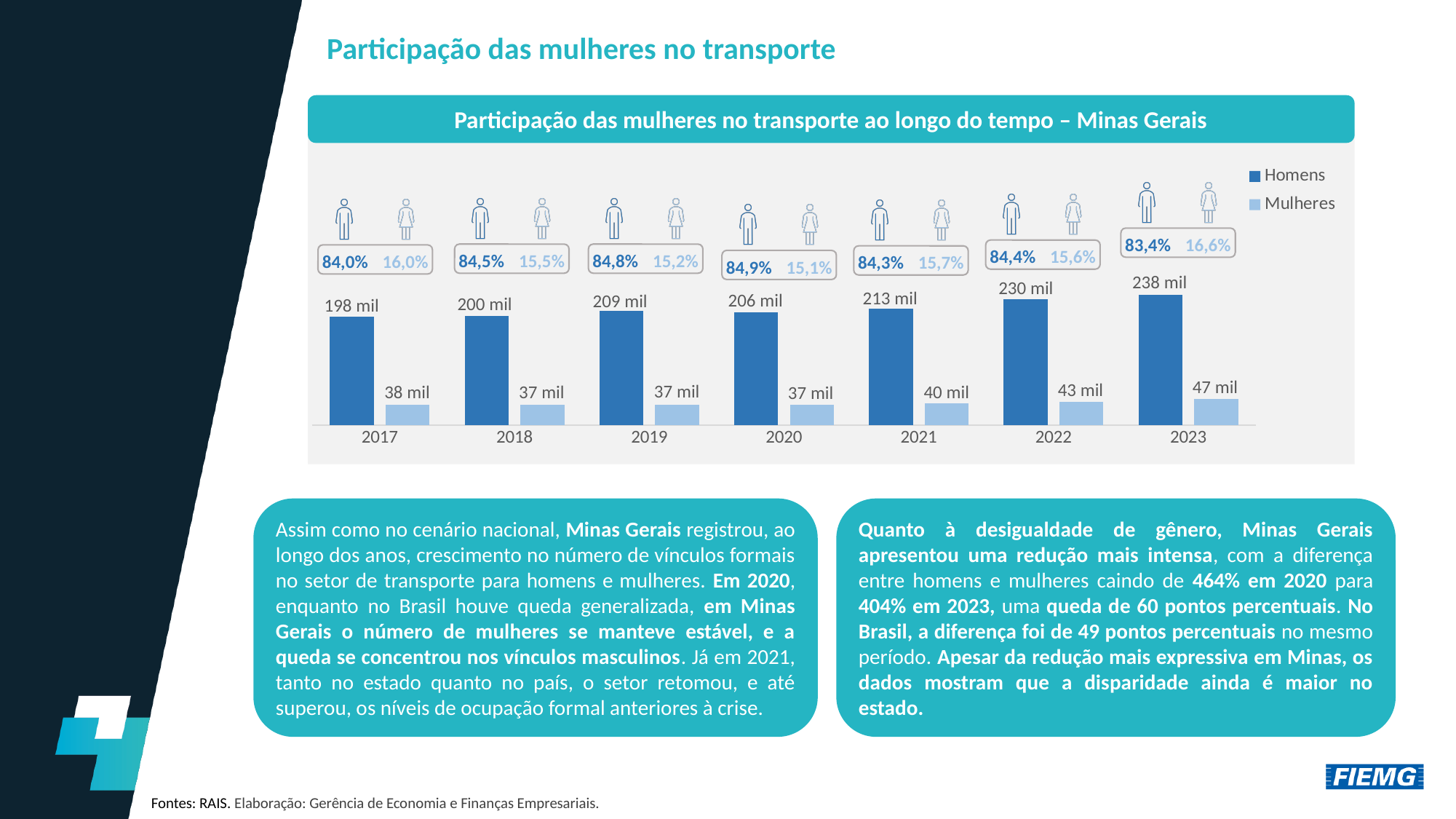
In which year is the Homens value highest? 2023 How many years are shown on the x axis? 7 What kind of chart is shown? Bar chart What percentage share is shown for Mulheres in 2023? 16,6% Which is larger, the Mulheres value in 2022 or in 2021? 2022 In which year is the Homens value lowest? 2017 What is the value for Mulheres in 2023? 47 mil What is the title of the chart? Participação das mulheres no transporte ao longo do tempo – Minas Gerais How many series does the legend list? 2 What is the difference between the Homens and Mulheres values in 2023? 191 mil What is the value for Homens in 2017? 198 mil What is the value for Mulheres in 2020? 37 mil